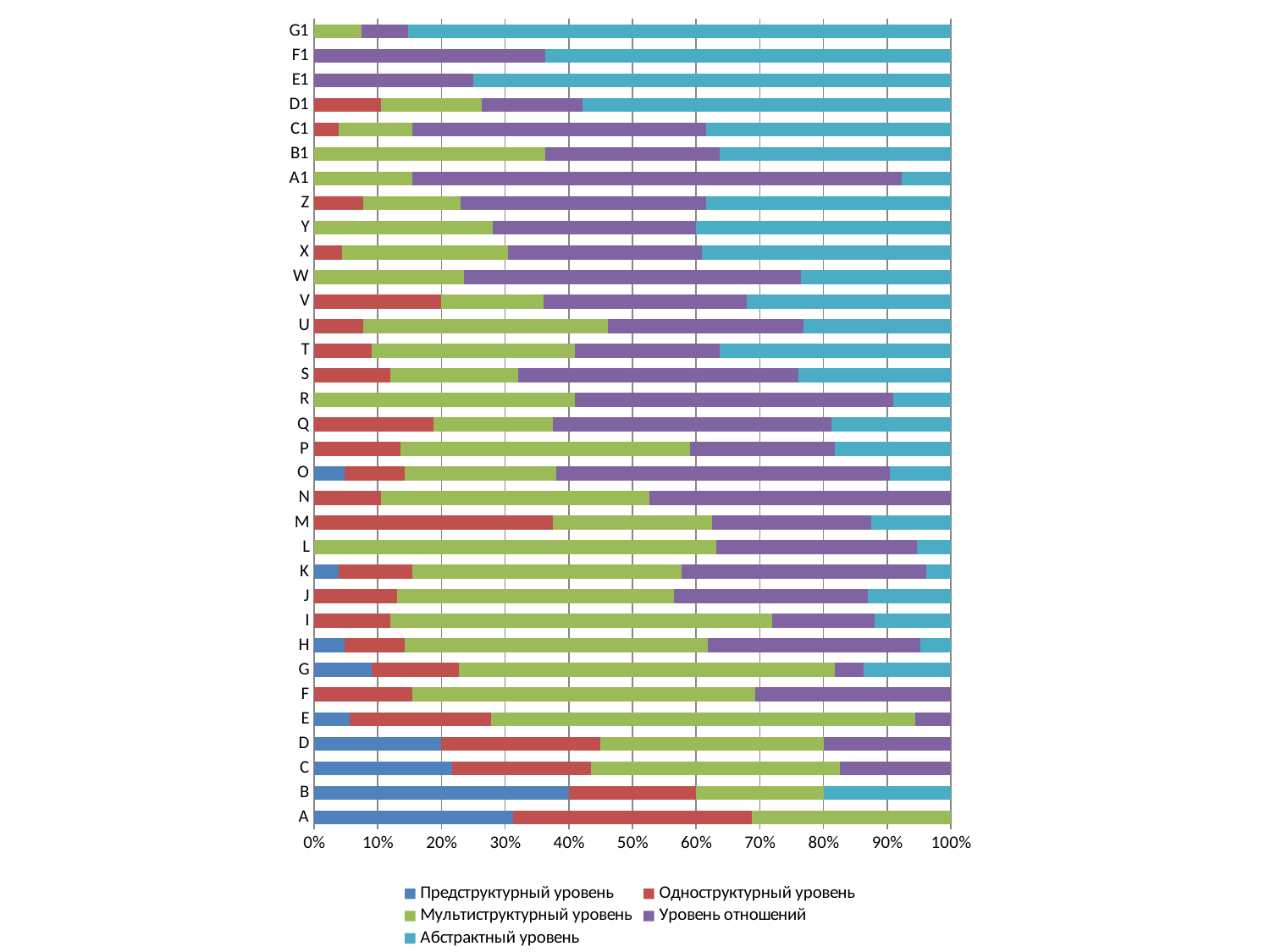
How many categories are plotted on the vertical axis? 33 Which has a larger share of Абстрактный уровень, category G1 or category A1? G1 What is the last series listed in the legend? Абстрактный уровень Is the value of Уровень отношений for category A1 greater or less than 70%? greater What is the value of Предструктурный уровень for category B? 40% Is the value of Абстрактный уровень for category G1 greater or less than 80%? greater Is the value of Абстрактный уровень for category E1 greater or less than 70%? greater Which category has the largest share of Предструктурный уровень? B Which series is shown in blue in the legend? Предструктурный уровень What kind of chart is shown on the slide? Stacked bar chart How many series does the legend list? 5